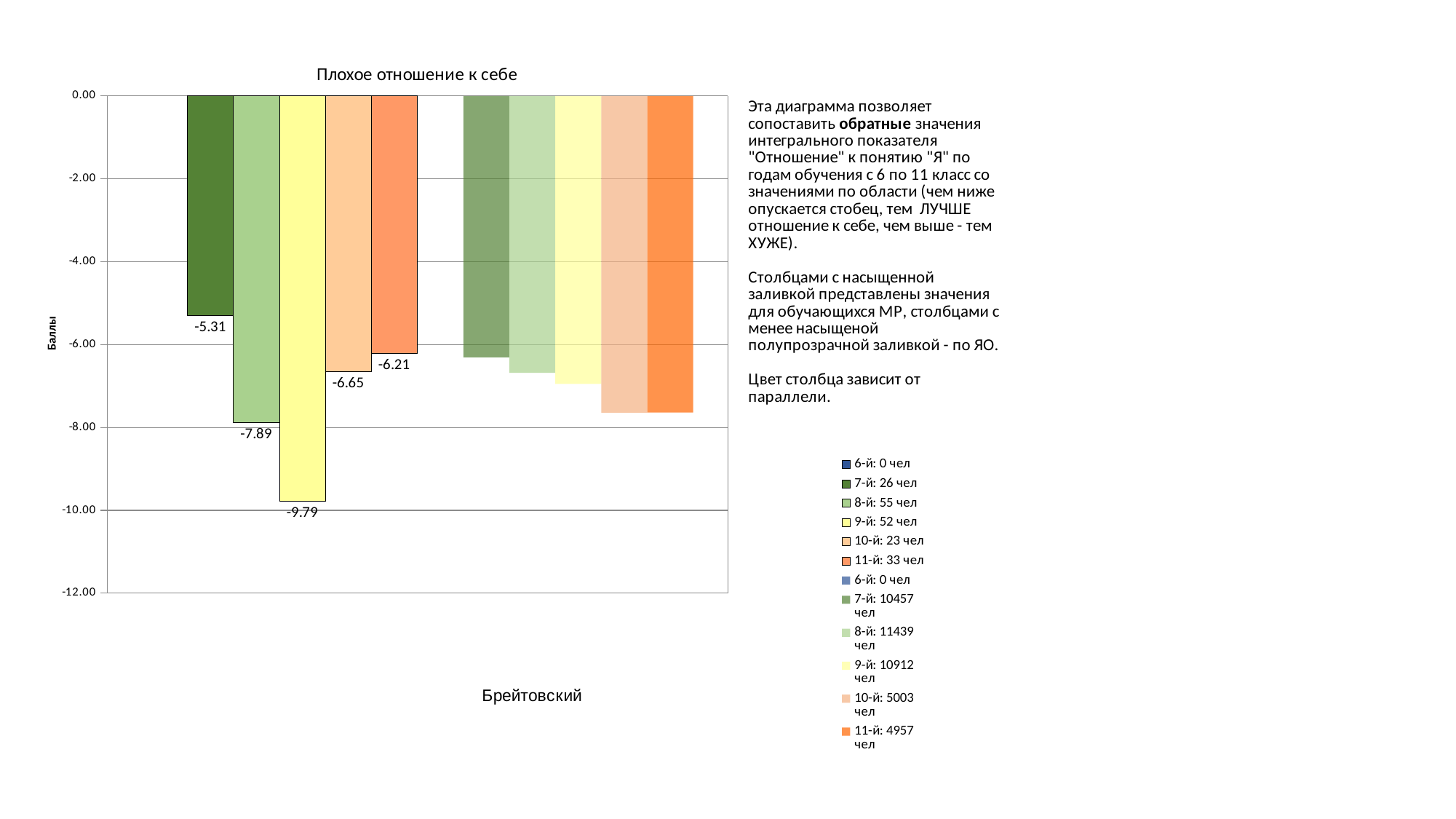
What is the title of the chart? Плохое отношение к себе What is the value of the labeled bar for the series '8-й: 55 чел'? -7.89 What is the value of the labeled bar for the series '9-й: 52 чел'? -9.79 What kind of chart is shown on the slide? bar chart What is the value of the labeled bar for the series '11-й: 33 чел'? -6.21 Among the bars with data labels, which series has the lowest value? 9-й: 52 чел Among the bars with data labels, which series has the highest value? 7-й: 26 чел What is the value of the labeled bar for the series '10-й: 23 чел'? -6.65 Is the value of the bar for '10-й: 5003 чел' greater or less than -8.00? greater What is the difference between the labeled values for '7-й: 26 чел' and '9-й: 52 чел'? 4.48 How many entries does the legend list? 12 What is the value of the labeled bar for the series '7-й: 26 чел'? -5.31